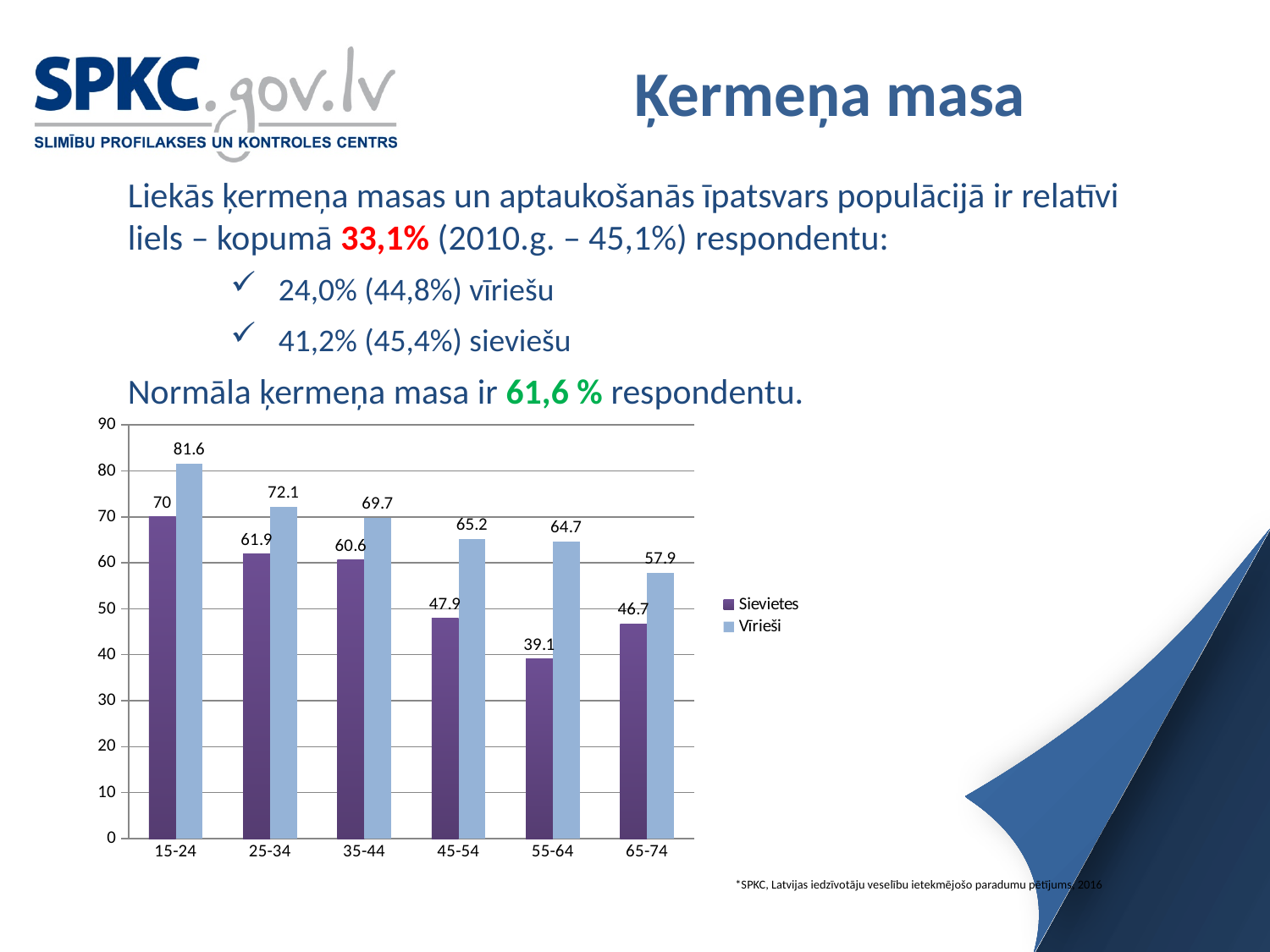
What is the value for Vīrieši in the 65-74 age group? 57.9 What is the difference between the Vīrieši and Sievietes values in the 45-54 age group? 17.3 Is the value for Vīrieši in the 35-44 age group greater or less than 60? greater How many series does the legend list? 2 Which age group has the lowest value for Sievietes? 55-64 Which age group has the highest value for Vīrieši? 15-24 What is the value for Sievietes in the 15-24 age group? 70 Do the values for Vīrieši rise or fall from the 15-24 to the 65-74 age group? fall What is the value for Sievietes in the 55-64 age group? 39.1 Which is larger in the 25-34 age group, the value for Sievietes or for Vīrieši? Vīrieši How many age groups are shown on the x axis? 6 What kind of chart is shown on the slide? bar chart